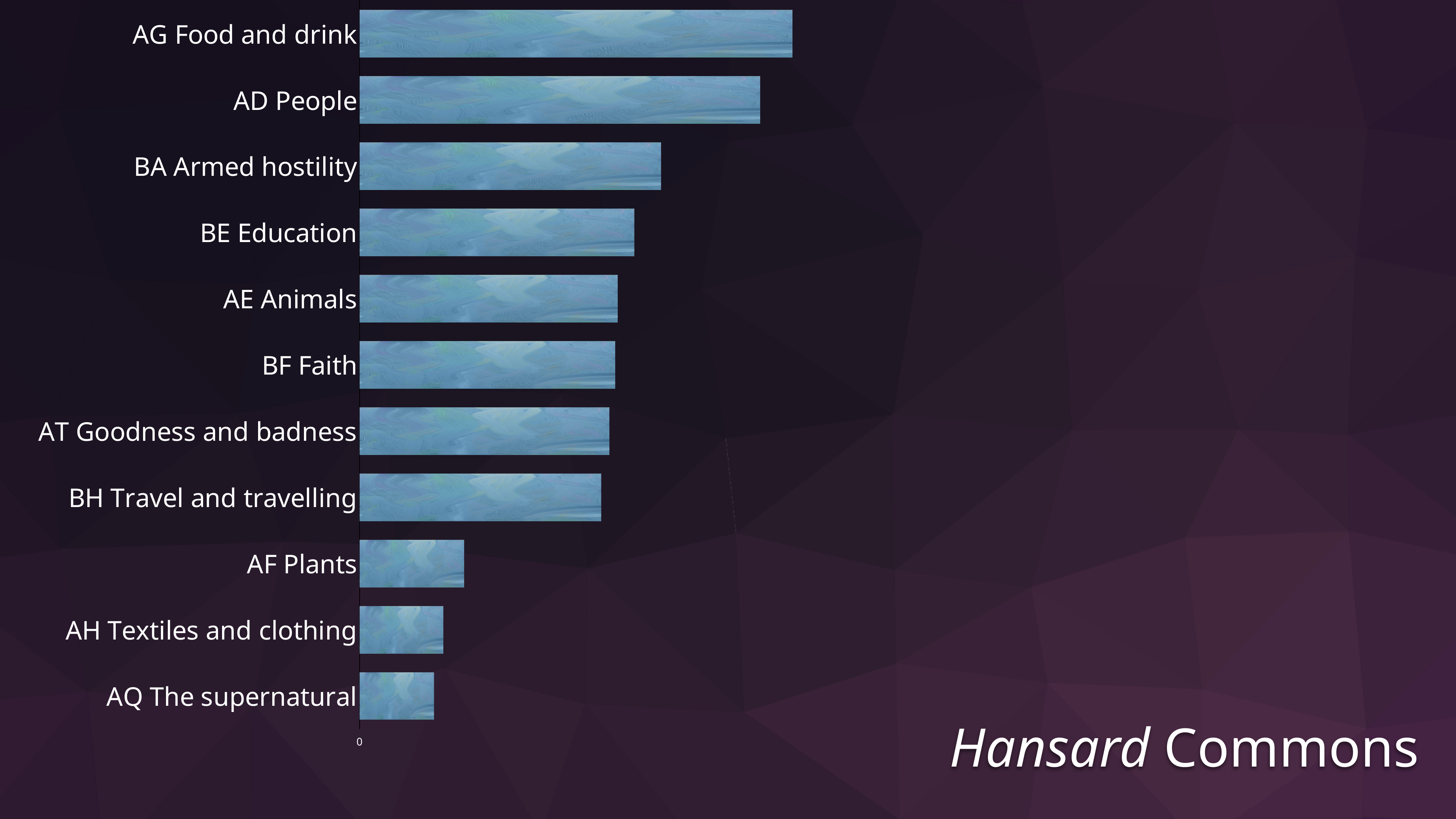
Which bar is longer, AG Food and drink or AF Plants? AG Food and drink Which category is listed at the top of the chart? AG Food and drink Which category has the longest bar in the chart? AG Food and drink What text appears in the bottom-right corner of the slide? Hansard Commons How many categories are plotted in the bar chart? 11 Which bar is longer, BH Travel and travelling or AF Plants? BH Travel and travelling Which bar is longer, AQ The supernatural or AT Goodness and badness? AT Goodness and badness What kind of chart is shown on the slide? bar chart Do the bar lengths increase or decrease going from the top category to the bottom category? decrease